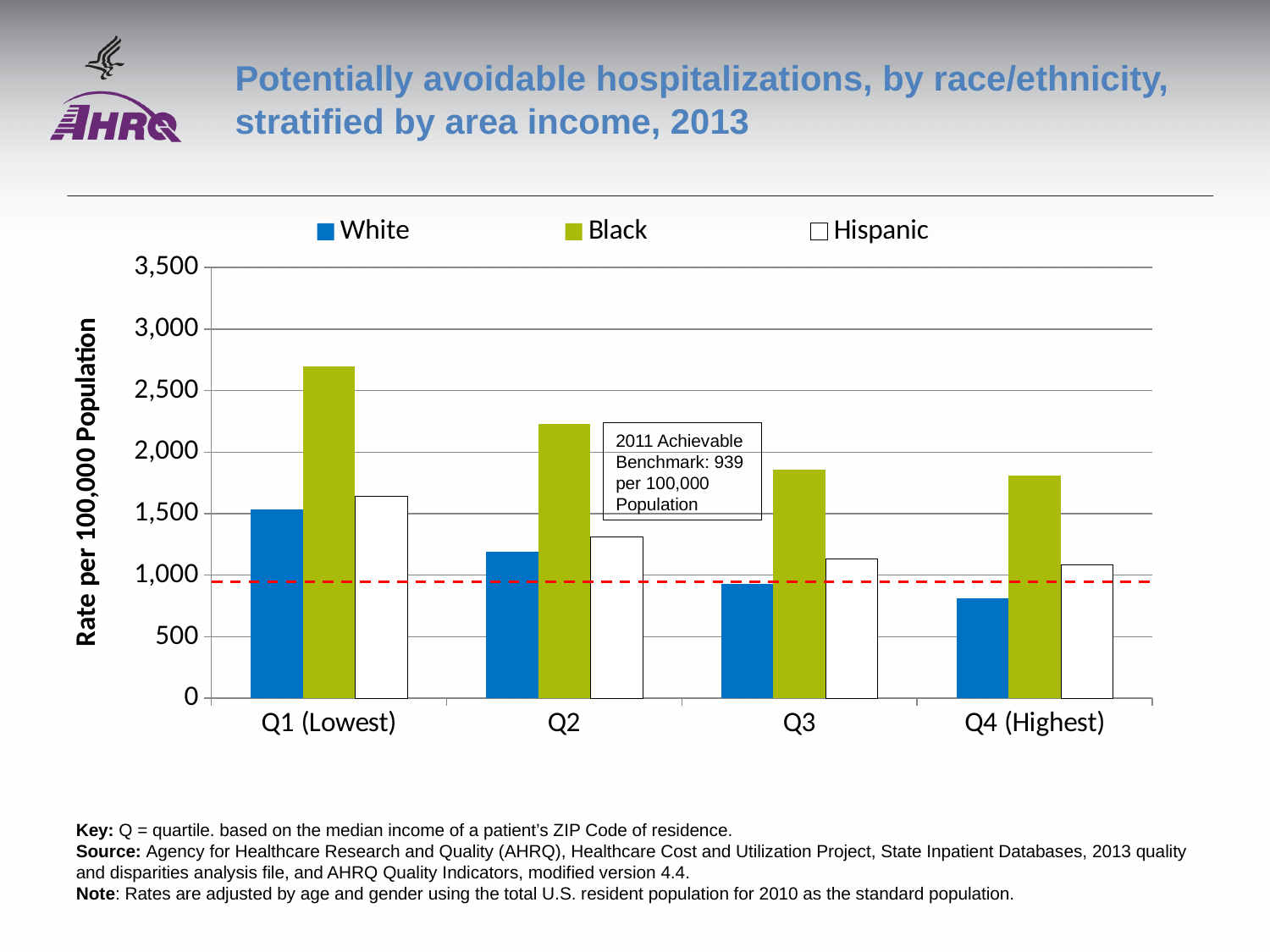
What kind of chart is shown on the slide? bar chart How many series does the legend list? 3 Which race/ethnicity group has the lowest rate in Q4 (Highest)? White Is the value for White in Q4 (Highest) greater or less than 1,000? less How many income quartile categories are shown on the x axis? 4 Which race/ethnicity group has the highest rate in Q1 (Lowest)? Black Is the value for Hispanic in Q2 greater or less than 1,500? less Which is larger, the Black rate in Q2 or the Black rate in Q3? Black rate in Q2 Do the White rates rise or fall from Q1 (Lowest) to Q4 (Highest)? fall Is the value for Black in Q1 (Lowest) greater or less than 2,500? greater What is the 2011 Achievable Benchmark shown on the chart? 939 per 100,000 Population What is the label of the y axis? Rate per 100,000 Population